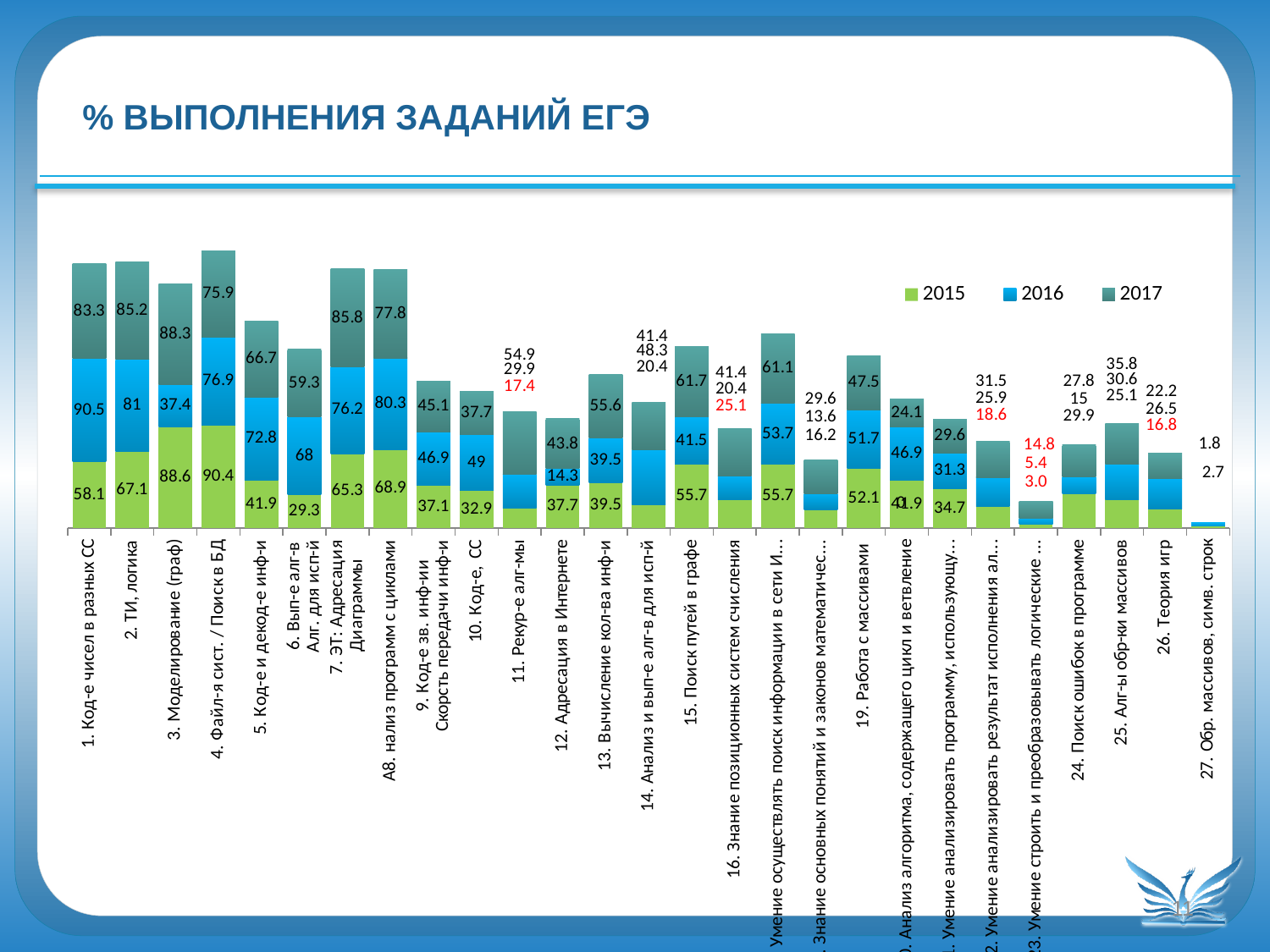
Which years are listed in the legend? 2015, 2016, 2017 How many series does the legend list? 3 What is the 2015 value for "1. Код-е чисел в разных СС"? 58.1 Which is larger: the 2015 value for "3. Моделирование (граф)" or the 2015 value for "1. Код-е чисел в разных СС"? 3. Моделирование (граф) Which category has the shortest stacked bar overall? 27. Обр. массивов, симв. строк What is the total of the stacked bar for "1. Код-е чисел в разных СС"? 231.9 What is the 2016 value for "2. ТИ, логика"? 81 What is the 2017 value for "7. ЭТ: Адресация Диаграммы"? 85.8 What kind of chart is shown on the slide? Stacked bar chart What is the difference between the 2016 and 2015 values for "1. Код-е чисел в разных СС"? 32.4 What is the 2015 value for "4. Файл-я сист. / Поиск в БД"? 90.4 Which category has the tallest stacked bar overall? 4. Файл-я сист. / Поиск в БД